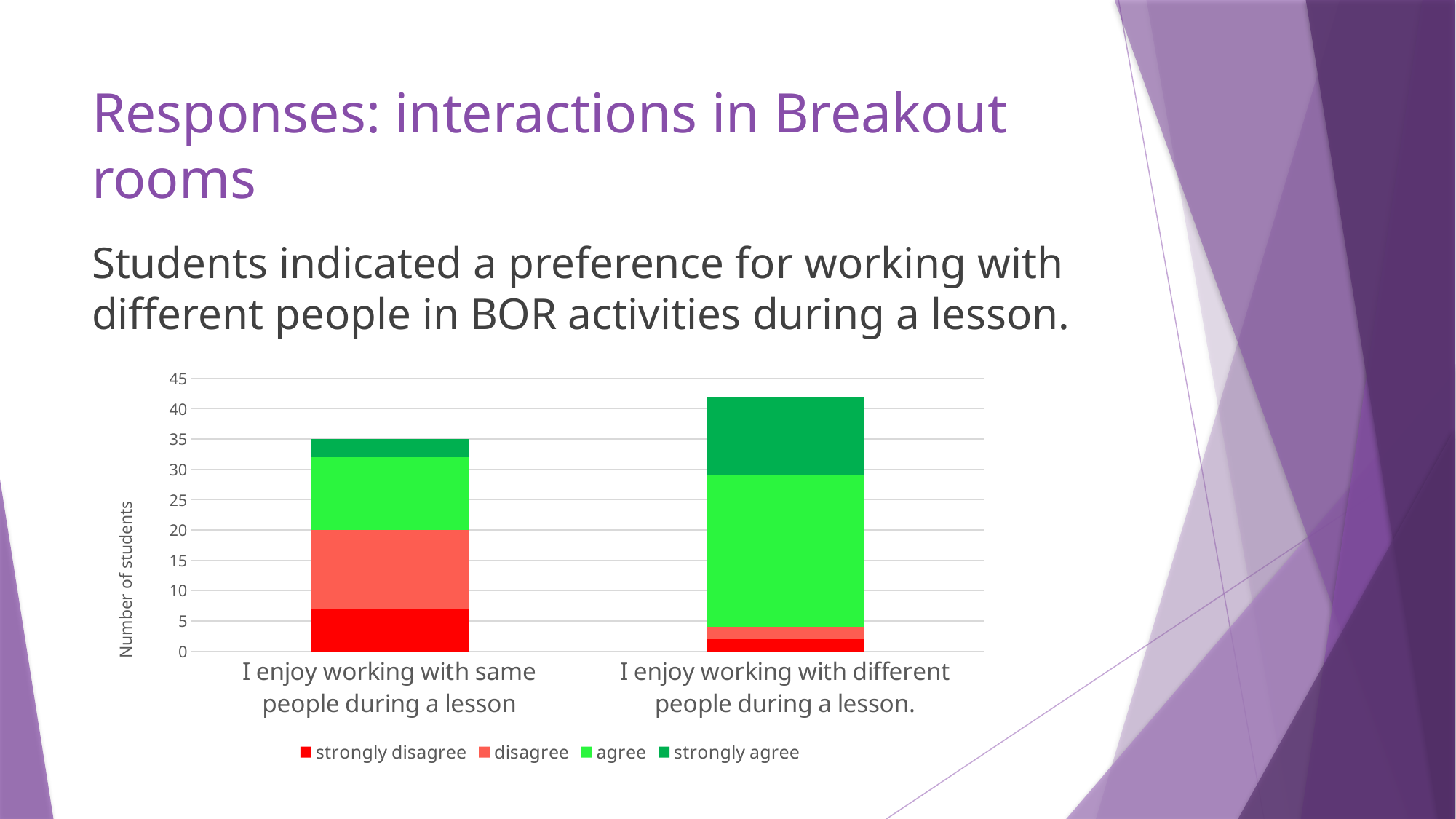
How many series does the chart's legend list? 4 What are the four series listed in the chart's legend? strongly disagree, disagree, agree, strongly agree What is the title of the vertical axis of the chart? Number of students How many categories are shown on the x axis of the chart? 2 What kind of chart is shown on the slide? stacked bar chart Is the 'strongly disagree' value for 'I enjoy working with different people during a lesson.' greater or less than 5? less Is the total stacked bar for 'I enjoy working with different people during a lesson.' greater or less than 40? greater Which category has the shorter stacked bar overall? I enjoy working with same people during a lesson Is the 'strongly disagree' value for 'I enjoy working with same people during a lesson' greater or less than 5? greater Which category has the larger 'agree' segment: 'I enjoy working with same people during a lesson' or 'I enjoy working with different people during a lesson.'? I enjoy working with different people during a lesson. Which category has the taller stacked bar overall? I enjoy working with different people during a lesson.